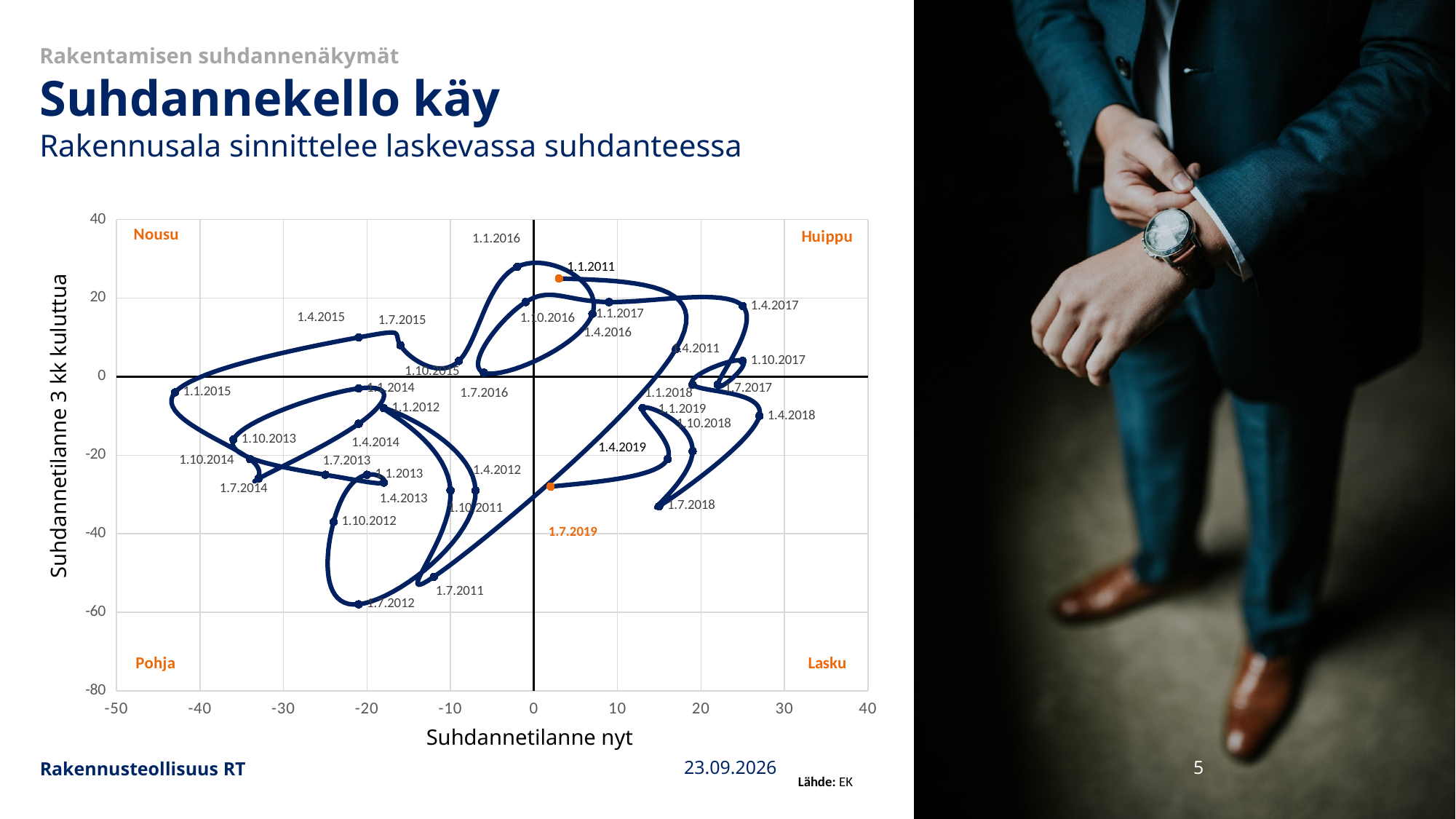
Is the horizontal-axis value for the point labelled 1.1.2015 greater or less than -40? less Which labelled point lies furthest to the left on the horizontal axis? 1.1.2015 Which label appears in the top-right corner of the chart? Huippu What is the title of the horizontal axis of the chart? Suhdannetilanne nyt Is the vertical-axis value for the point labelled 1.1.2016 greater or less than 20? greater Which labelled point has the lowest vertical-axis value? 1.7.2012 Which point has the higher vertical-axis value, 1.1.2011 or 1.7.2019? 1.1.2011 Is the vertical-axis value for the point labelled 1.7.2012 greater or less than -40? less Which point has the higher vertical-axis value, 1.4.2017 or 1.7.2018? 1.4.2017 What kind of chart is shown on the slide? Scatter (line) chart